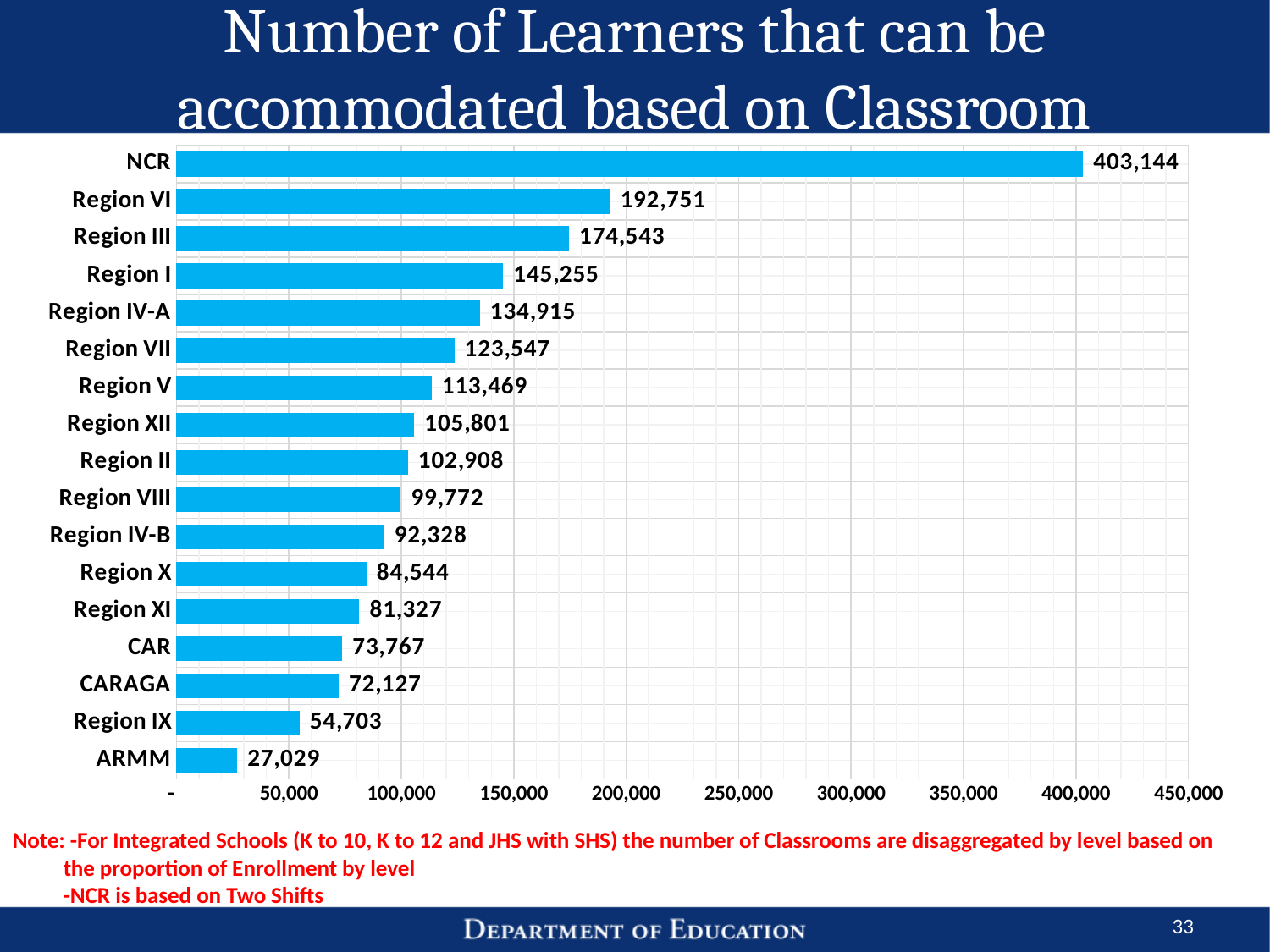
Which region has the highest number of learners that can be accommodated? NCR What is the difference between the values for Region IX and ARMM? 27,674 Is the value for Region XII greater or less than 100,000? greater What is the value shown for Region VII? 123,547 What is the highest value labelled on the horizontal axis? 450,000 What is the value shown for CARAGA? 72,127 How many regions are shown in the chart? 17 Which is larger, the value for Region I or the value for Region IV-A? Region I What is the number of learners that can be accommodated in NCR? 403,144 What is the difference between the values for Region VI and Region III? 18,208 Which region has the lowest number of learners that can be accommodated? ARMM What kind of chart is shown on the slide? Bar chart